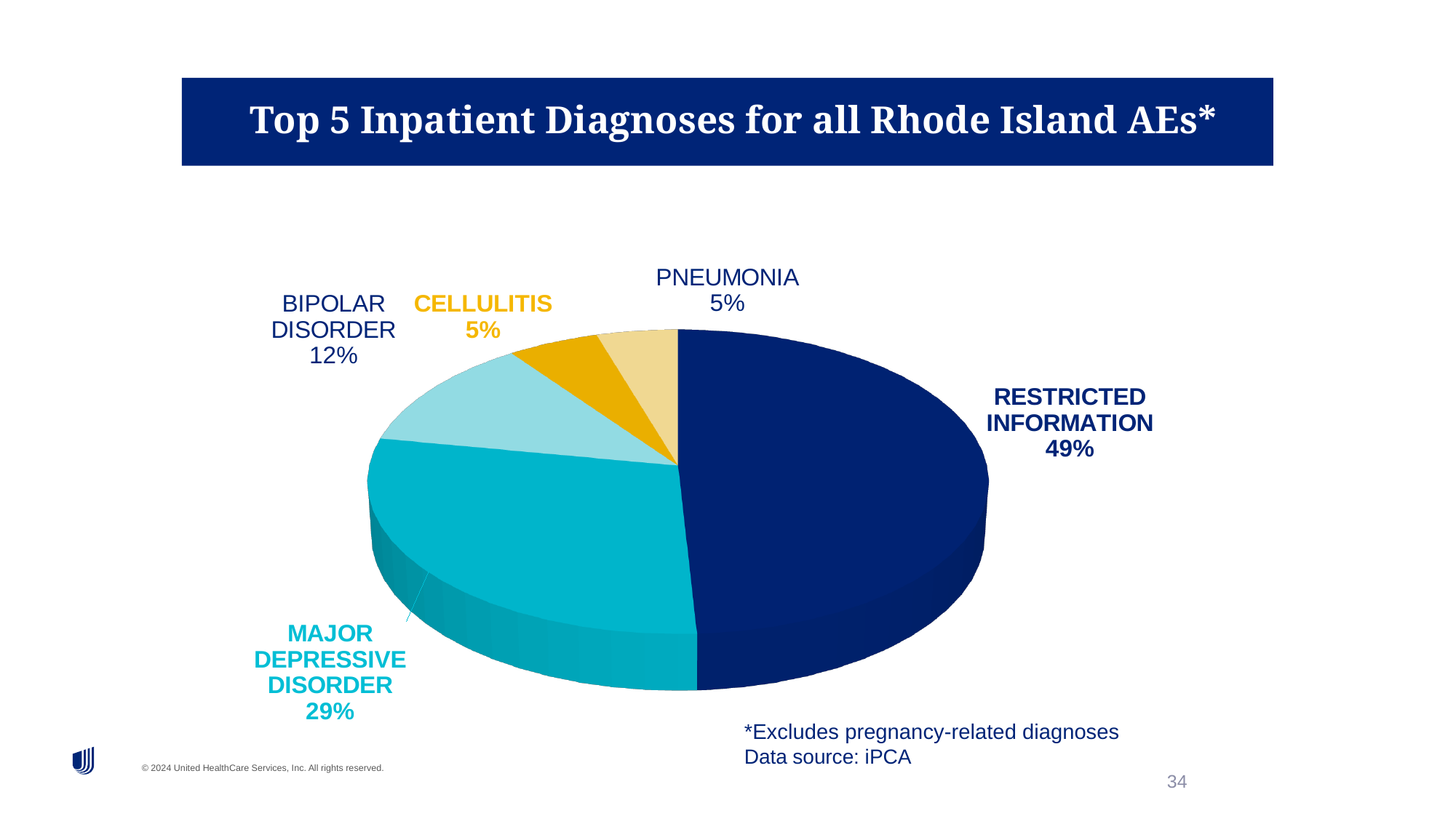
Which category has the larger share, Major Depressive Disorder or Bipolar Disorder? Major Depressive Disorder What share of the pie does Restricted Information represent? 49% What is the difference in percentage points between Bipolar Disorder and Cellulitis? 7 How many slices does the pie chart have? 5 What data source is cited below the chart? iPCA What percentage is shown for Bipolar Disorder? 12% What is the difference in percentage points between Restricted Information and Major Depressive Disorder? 20 What type of chart is shown on the slide? Pie chart What is the title of the chart on the slide? Top 5 Inpatient Diagnoses for all Rhode Island AEs* Which diagnosis category has the largest slice of the pie? Restricted Information What percentage is shown for Pneumonia? 5% What percentage is shown for Major Depressive Disorder? 29%